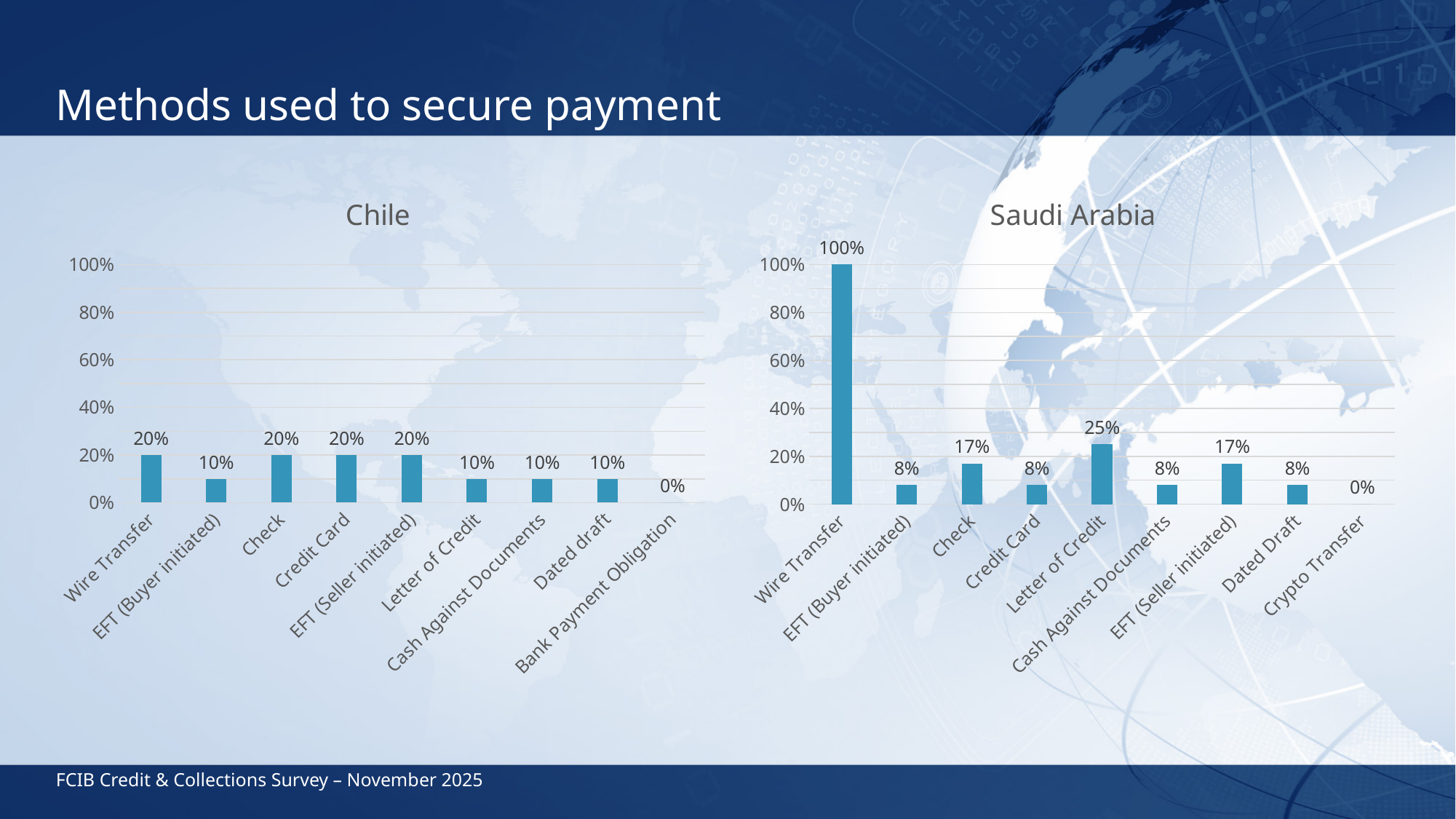
In the Saudi Arabia chart, what is the difference between Wire Transfer and Letter of Credit? 75% In the Chile chart, what is the value for Wire Transfer? 20% In the Saudi Arabia chart, what is the value for Check? 17% In the Saudi Arabia chart, which category has the lowest value? Crypto Transfer In the Chile chart, what is the value for Letter of Credit? 10% In the Saudi Arabia chart, what is the value for Letter of Credit? 25% What kind of chart is the Saudi Arabia chart? Bar chart How many categories are shown in the Chile chart? 9 In the Chile chart, what is the value for Bank Payment Obligation? 0% In the Chile chart, what is the difference between Check and EFT (Buyer initiated)? 10% In the Saudi Arabia chart, which category has the highest value? Wire Transfer In the Saudi Arabia chart, which is larger, Check or Dated Draft? Check